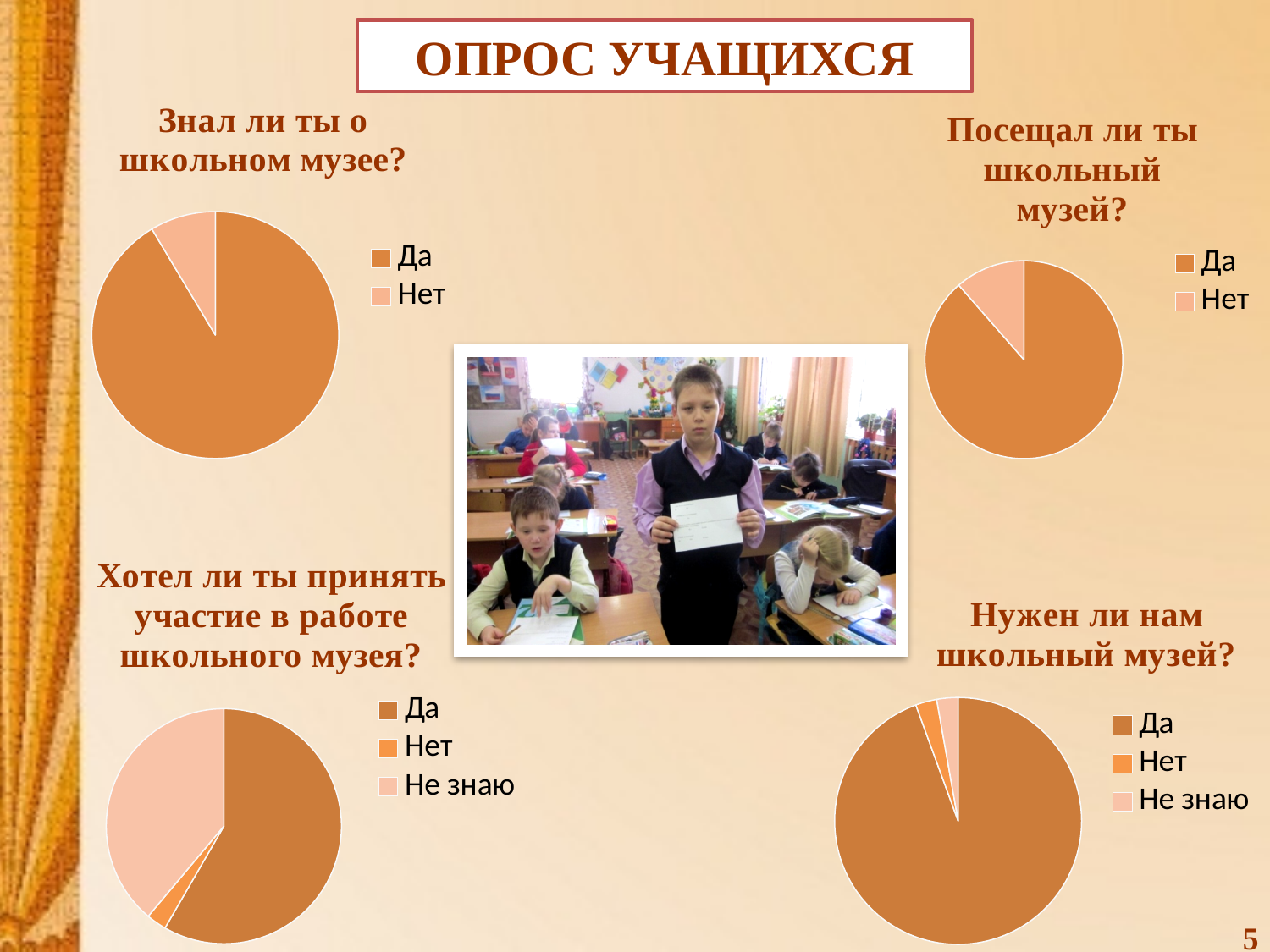
In the chart "Нужен ли нам школьный музей?", which answer has the largest share? Да How many slices does the chart "Хотел ли ты принять участие в работе школьного музея?" have? 3 How many pie charts are shown on the slide? 4 In the chart "Посещал ли ты школьный музей?", which answer has the smallest share? Нет What kind of chart is used for "Знал ли ты о школьном музее?"? pie chart How many entries does the legend of the chart "Нужен ли нам школьный музей?" list? 3 What is the title of the chart in the top-right corner of the slide? Посещал ли ты школьный музей? In the chart "Знал ли ты о школьном музее?", which answer has the largest share? Да In the chart "Хотел ли ты принять участие в работе школьного музея?", which is larger, Да or Не знаю? Да How many entries does the legend of the chart "Знал ли ты о школьном музее?" list? 2 In the chart "Хотел ли ты принять участие в работе школьного музея?", which answer has the smallest share? Нет In the chart "Посещал ли ты школьный музей?", which is larger, Да or Нет? Да